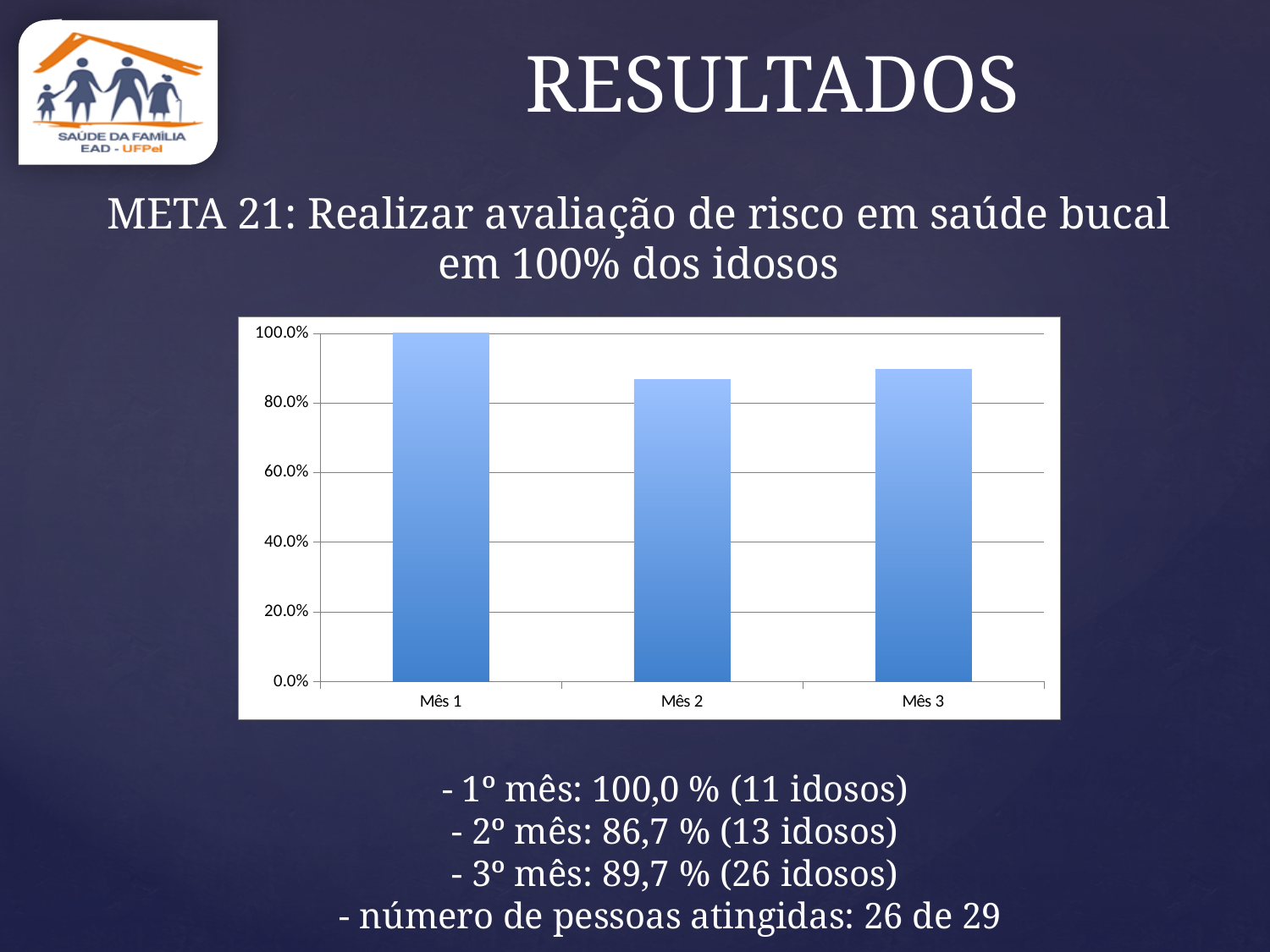
Is the value for Mês 3 greater or less than 100.0%? less According to the slide, what percentage was reached in the 3º mês? 89,7 % Which is larger, the value for Mês 2 or the value for Mês 3? Mês 3 How many categories (months) are plotted on the chart? 3 What type of chart is shown on the slide? bar chart Which month has the highest value? Mês 1 Is the value for Mês 2 greater or less than 80.0%? greater According to the slide, what percentage was reached in the 2º mês? 86,7 % Which month has the lowest value? Mês 2 What is the value for Mês 1? 100.0% Does the value rise or fall from Mês 1 to Mês 2? fall What is the highest value shown on the vertical axis? 100.0%